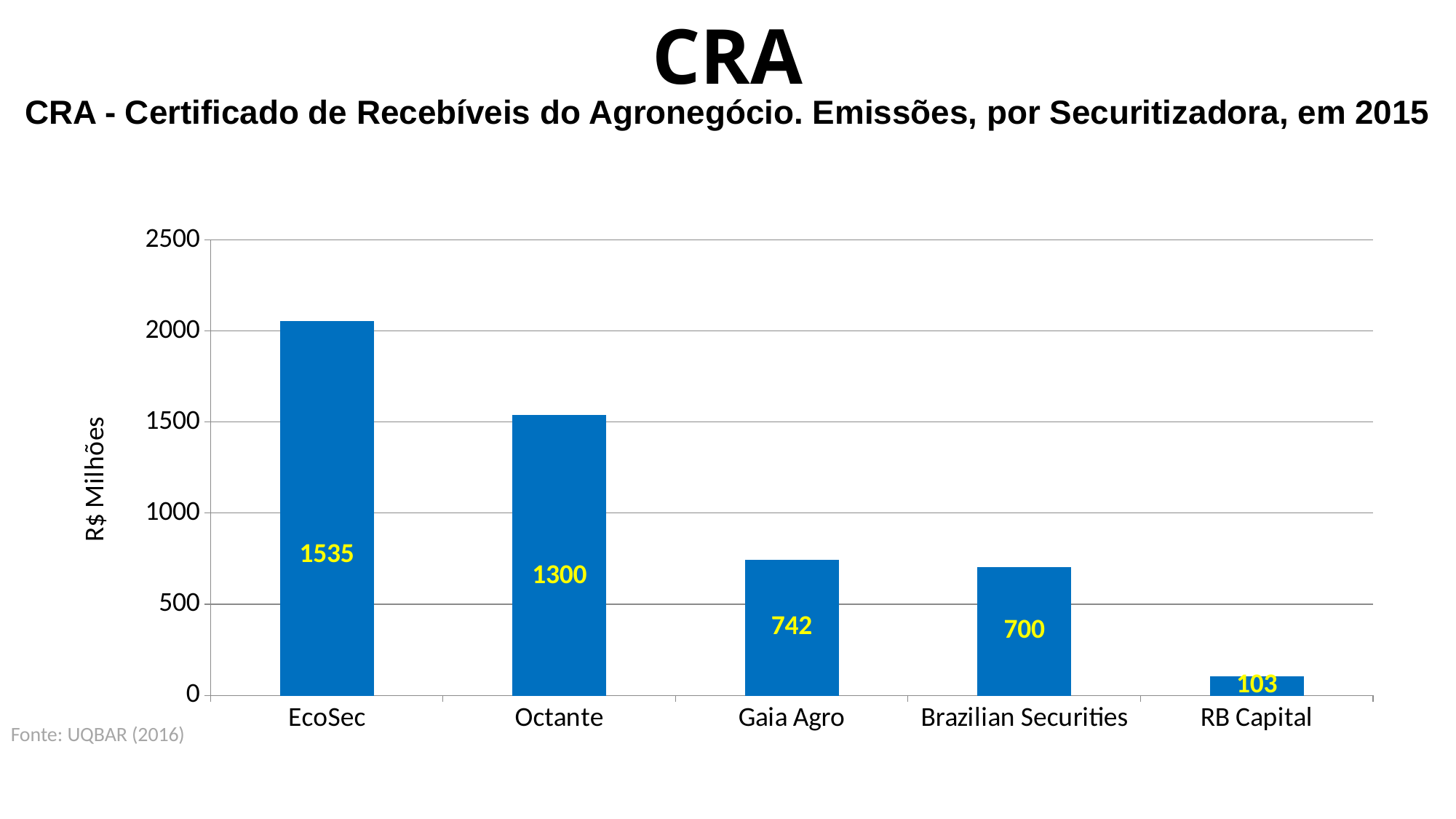
What is the value shown for RB Capital? 103 How many securitizadoras are shown on the chart? 5 What kind of chart is shown on the slide? bar chart Is the value for RB Capital greater or less than 500? less What is the value shown for Gaia Agro? 742 What is the value shown for Octante? 1300 What is the label on the vertical axis? R$ Milhões Which is larger, the value for Gaia Agro or the value for Brazilian Securities? Gaia Agro What is the value shown for EcoSec? 1535 Which securitizadora has the highest value? EcoSec Which securitizadora has the lowest value? RB Capital What is the difference between the values for EcoSec and Octante? 235